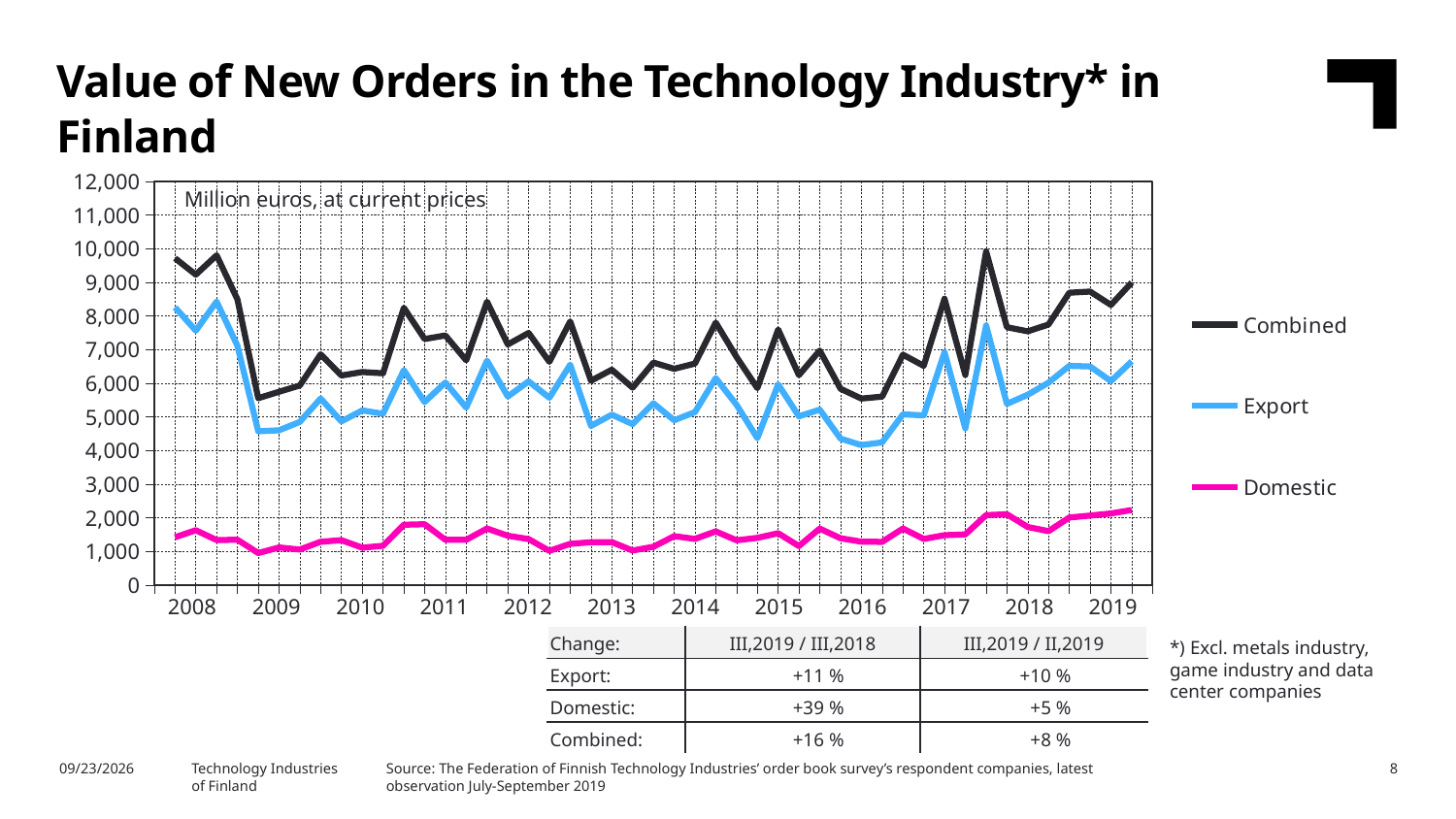
How many series does the legend list? 3 What unit is stated in the label inside the chart area? Million euros, at current prices Is the value for Domestic at the end of 2019 greater or less than 3,000? less How many years are labelled on the x axis? 12 Is the value for Export at its low point in 2009 greater or less than 5,000? less Which series has the lowest values throughout the chart? Domestic Which series has the highest values throughout the chart? Combined What kind of chart is shown on the slide? line chart Which is larger in 2016, the Export value or the Domestic value? Export Is the value for Combined at the start of 2008 greater or less than 9,000? greater Does the Combined line rise or fall from the start of 2008 to 2009? fall